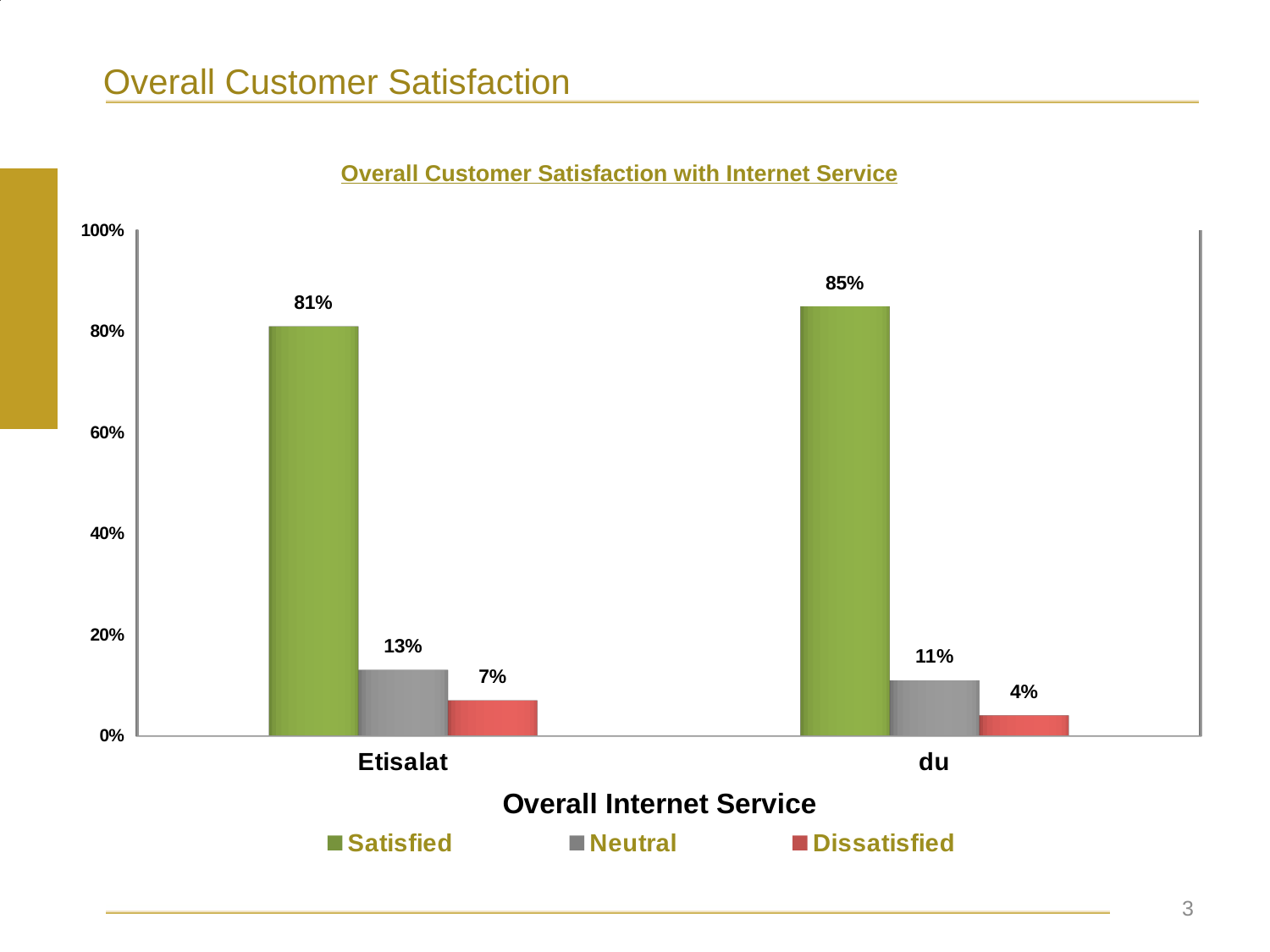
How many series does the legend list? 3 What is the Neutral value for du? 11% What percentage of Etisalat customers are Satisfied? 81% Is the Satisfied value for Etisalat greater or less than 80%? greater What percentage of du customers are Dissatisfied? 4% What kind of chart is shown on the slide? bar chart What is the difference between the Neutral percentages for Etisalat and du? 2% What is the difference between the Satisfied percentages for du and Etisalat? 4% What is the title of the chart? Overall Customer Satisfaction with Internet Service Which provider has the lowest Dissatisfied percentage? du Which provider has the higher Satisfied percentage? du How many providers are shown on the x axis? 2